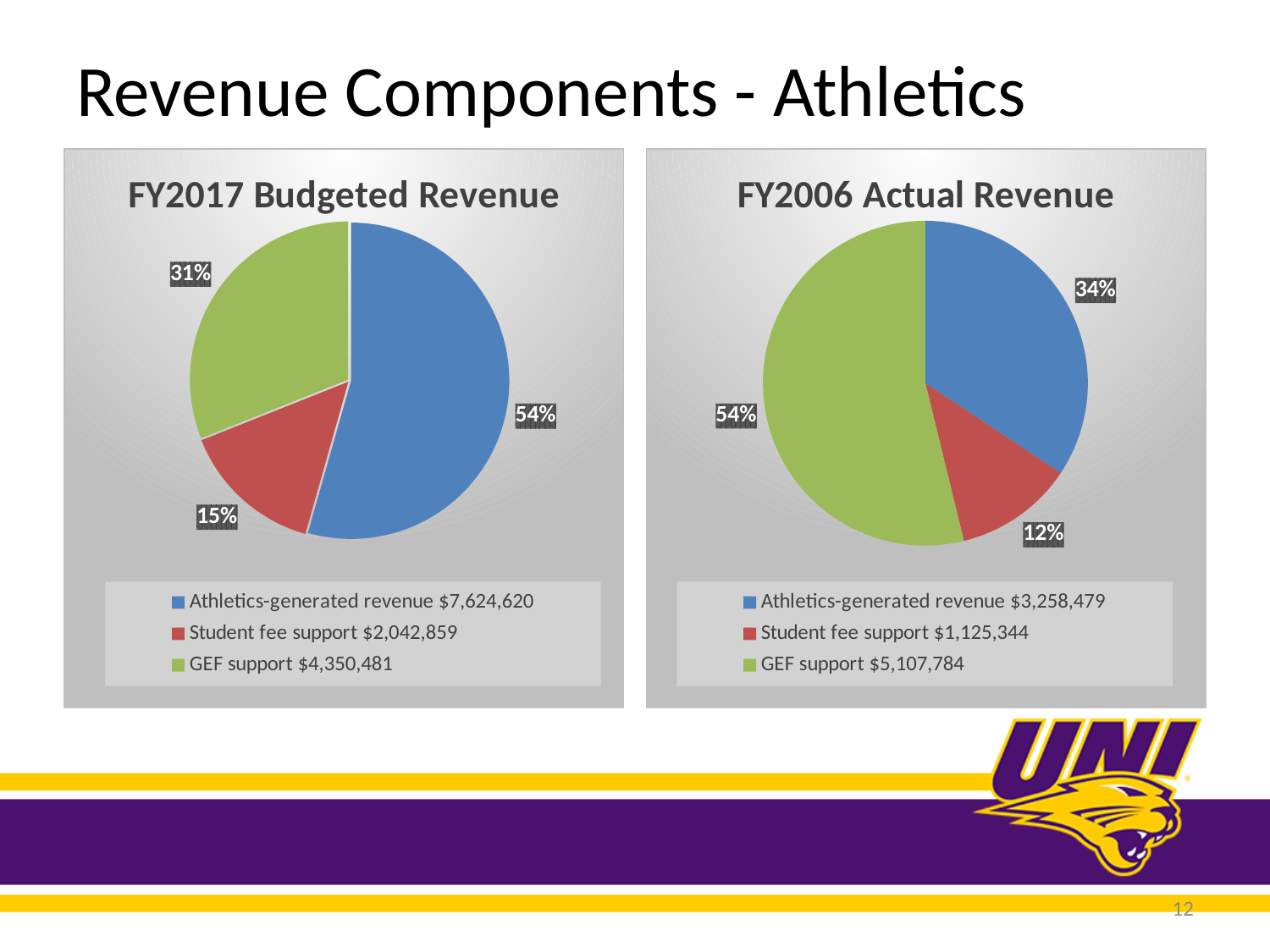
What type of chart is the FY2006 Actual Revenue chart? Pie chart In the FY2017 Budgeted Revenue chart, what share of the pie is GEF support? 31% In the FY2006 Actual Revenue chart, what share of the pie is GEF support? 54% How many categories does the legend of the FY2017 Budgeted Revenue chart list? 3 In the FY2017 Budgeted Revenue chart, what share of the pie is Student fee support? 15% In the FY2006 Actual Revenue chart, which category has the smallest slice? Student fee support In the FY2017 Budgeted Revenue chart, what dollar amount does the legend give for GEF support? $4,350,481 In the FY2017 Budgeted Revenue chart, which category has the largest slice? Athletics-generated revenue In the FY2017 Budgeted Revenue chart, what is the difference in percentage points between the Athletics-generated revenue slice and the GEF support slice? 23 percentage points In the FY2006 Actual Revenue chart, which is larger, the GEF support slice or the Athletics-generated revenue slice? GEF support